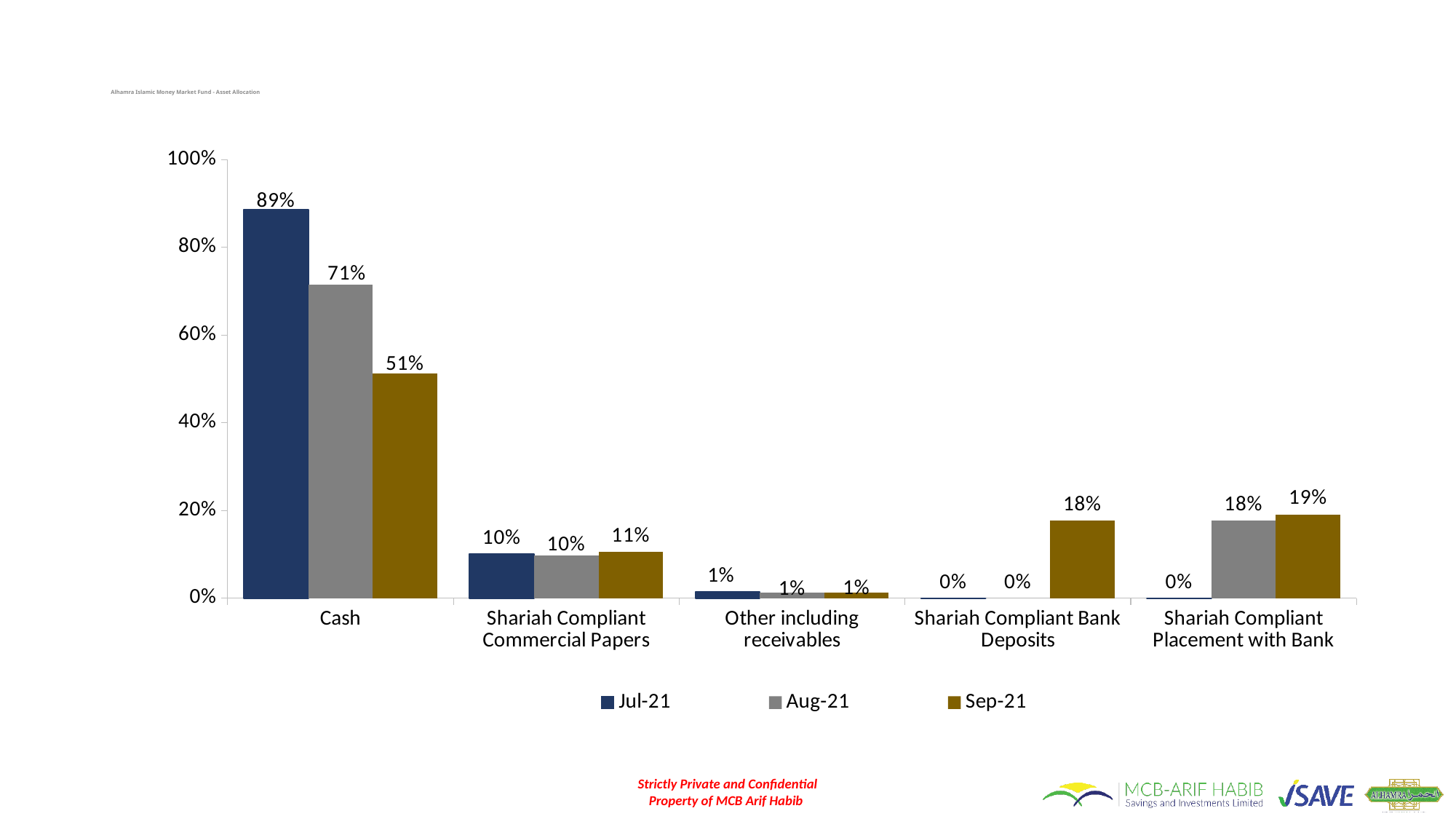
What kind of chart is shown on the slide? Bar chart Do the Cash values rise or fall from Jul-21 to Sep-21? Fall What is the Aug-21 value for Shariah Compliant Placement with Bank? 18% How many categories are shown on the x axis? 5 How many series does the legend list? 3 Which category has the highest Sep-21 value? Cash What is the Jul-21 value for Cash? 89% Which series is shown in grey in the legend? Aug-21 Is the Aug-21 value for Cash greater or less than 60%? greater What is the difference between the Jul-21 and Sep-21 values for Cash? 38% Which is larger for Shariah Compliant Commercial Papers: the Jul-21 value or the Sep-21 value? Sep-21 What is the Sep-21 value for Shariah Compliant Bank Deposits? 18%